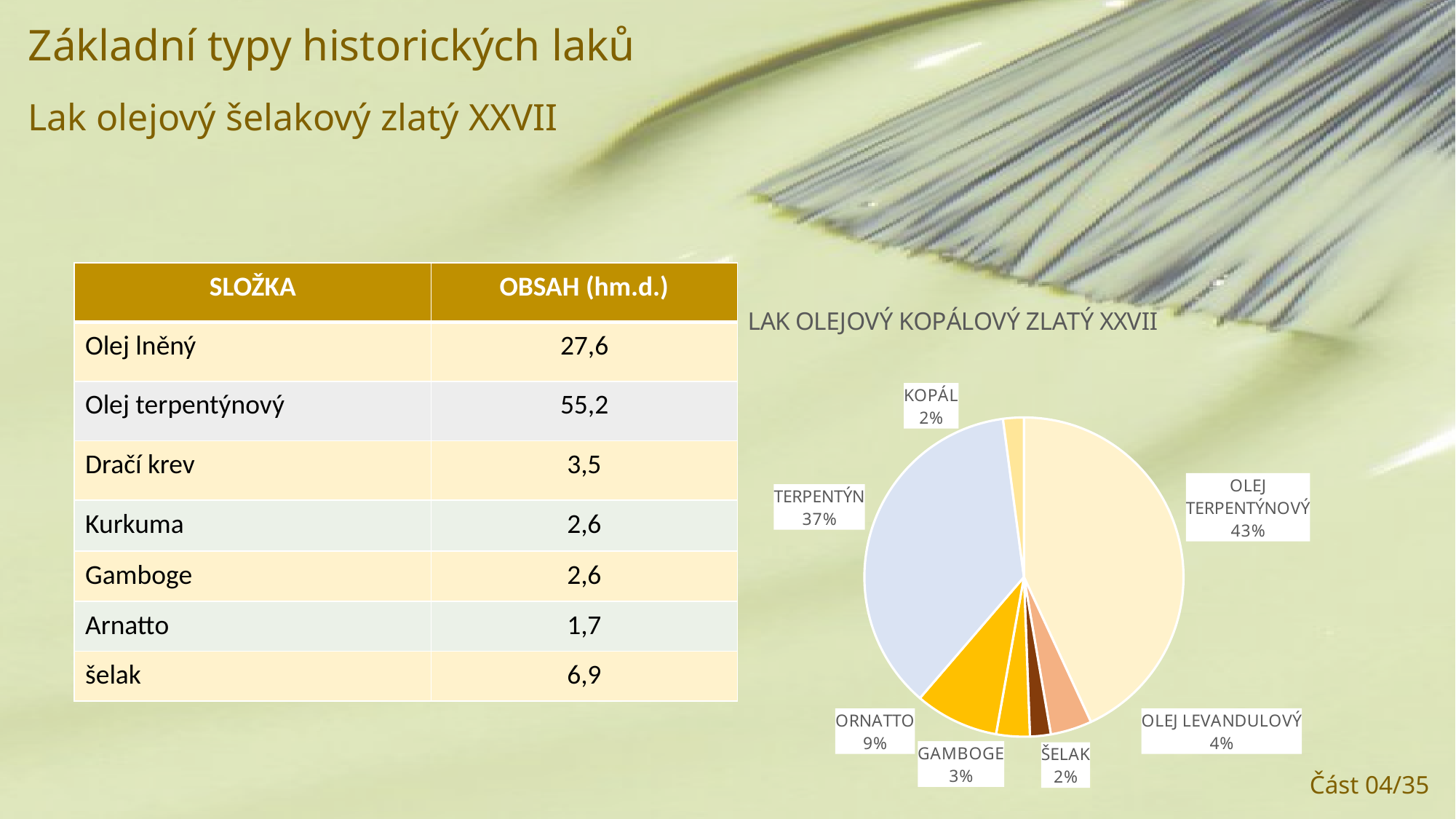
What kind of chart is shown on the slide? pie chart What percentage is shown for ORNATTO in the pie chart? 9% In the pie chart, which is larger: ORNATTO or OLEJ LEVANDULOVÝ? ORNATTO Which slice of the pie chart is the largest? OLEJ TERPENTÝNOVÝ What percentage is shown for OLEJ LEVANDULOVÝ in the pie chart? 4% What percentage is shown for GAMBOGE in the pie chart? 3% What share of the pie chart does OLEJ TERPENTÝNOVÝ have? 43% How many slices does the pie chart have? 7 What percentage is shown for KOPÁL in the pie chart? 2% In the pie chart, what is the difference in percentage points between OLEJ TERPENTÝNOVÝ and TERPENTÝN? 6 What is the title of the pie chart? LAK OLEJOVÝ KOPÁLOVÝ ZLATÝ XXVII What share of the pie chart does TERPENTÝN have? 37%